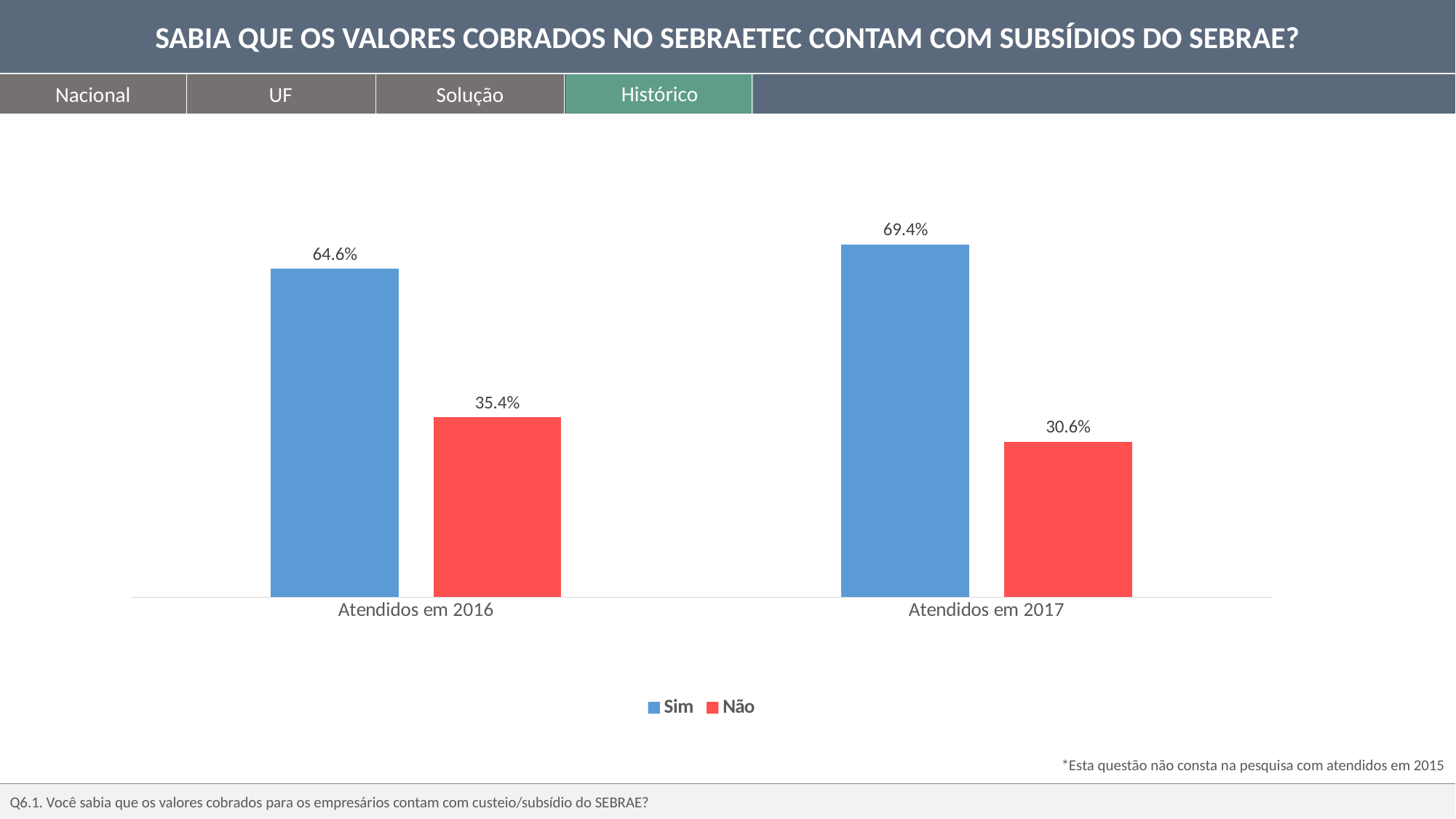
What is the difference between the Sim and Não values for Atendidos em 2016? 29.2% What is the value for Não for Atendidos em 2017? 30.6% How many series does the legend list? 2 What is the value for Não for Atendidos em 2016? 35.4% What kind of chart is shown on the slide? Bar chart What is the value for Sim for Atendidos em 2016? 64.6% Which is larger: Não for Atendidos em 2016 or Não for Atendidos em 2017? Não for Atendidos em 2016 Which category has the highest Sim value? Atendidos em 2017 What is the value for Sim for Atendidos em 2017? 69.4% What is the difference between the Sim values for Atendidos em 2017 and Atendidos em 2016? 4.8% How many categories are shown on the x axis? 2 Which category has the lowest Não value? Atendidos em 2017